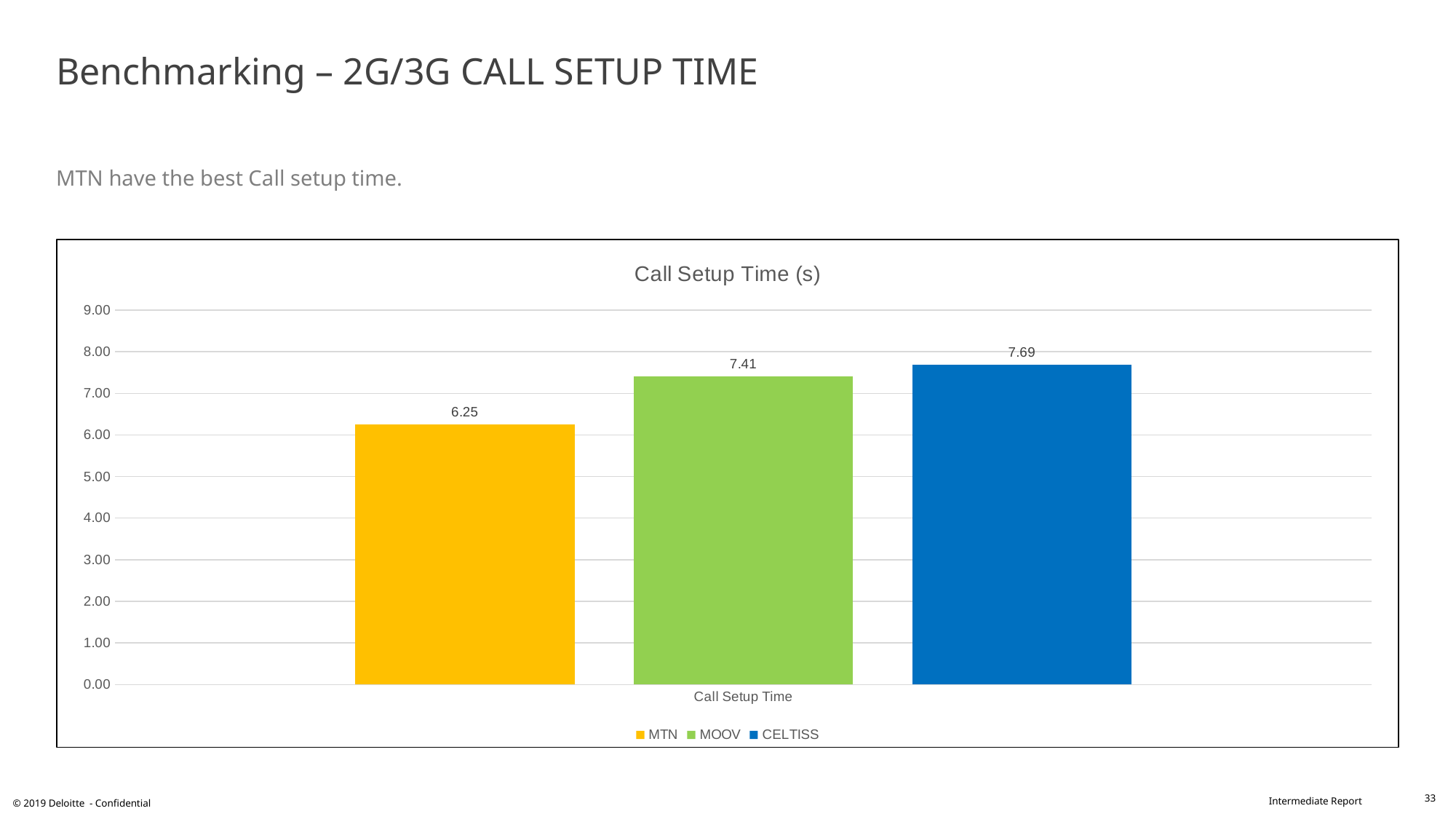
What is the difference between the call setup times of MOOV and MTN? 1.16 Which operator has the highest call setup time? CELTISS Is the call setup time for MTN greater or less than 7.00? less Which operator has the lowest call setup time? MTN What is the difference between the call setup times of CELTISS and MTN? 1.44 Which has a larger call setup time, MOOV or MTN? MOOV What is the call setup time for CELTISS? 7.69 What is the title of the chart? Call Setup Time (s) How many series does the legend list? 3 What is the call setup time for MOOV? 7.41 What kind of chart is shown on the slide? Bar chart What is the call setup time for MTN? 6.25